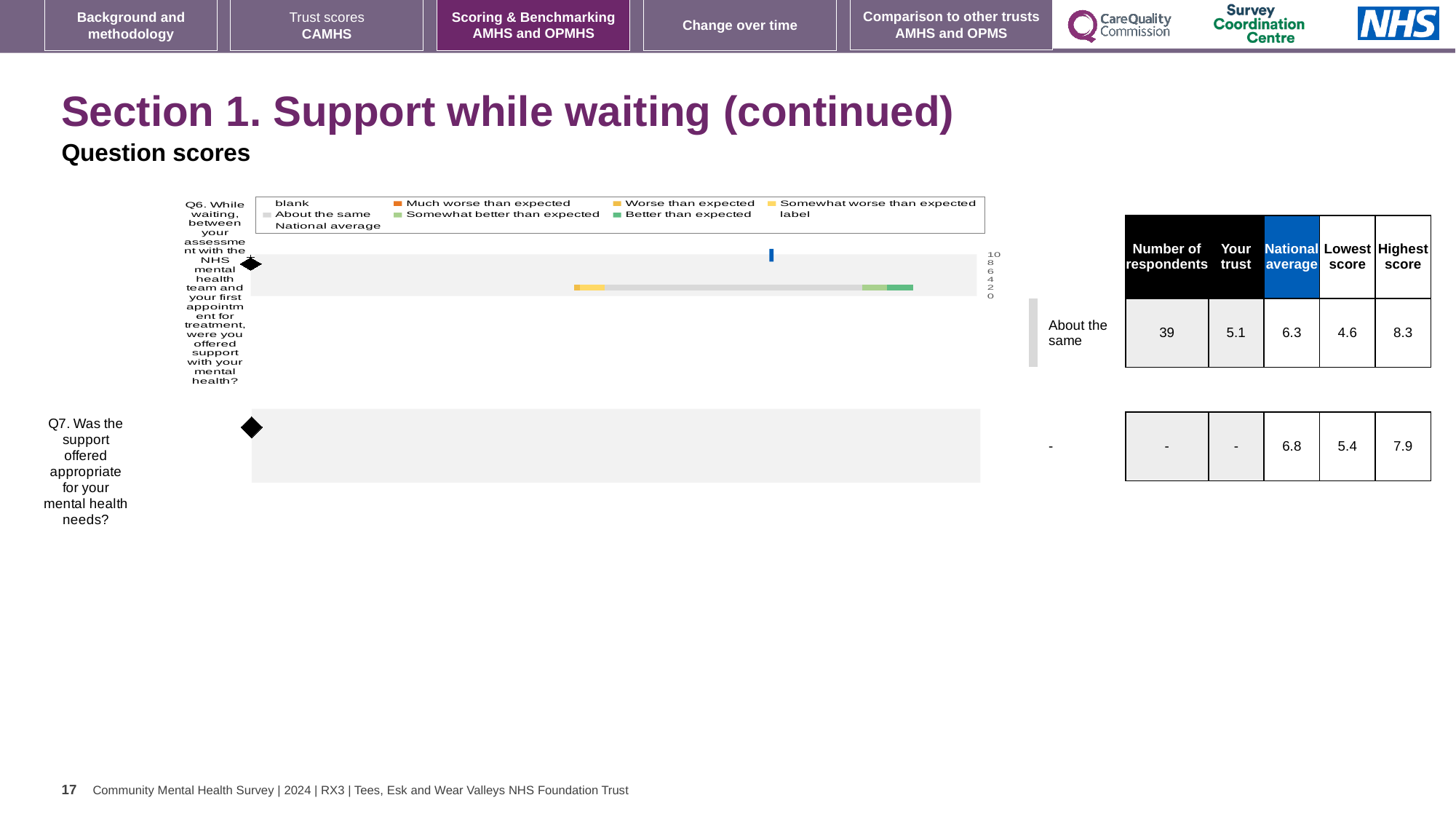
What is the national average score for Q6? 6.3 What is the highest score for Q6? 8.3 What is the maximum value shown on the chart's score axis? 10 What is the 'Your trust' score for Q6 in the table next to the chart? 5.1 How many respondents are listed for Q6? 39 What is the lowest score for Q7? 5.4 What is the difference between the highest and lowest scores for Q6? 3.7 What is the difference between the highest and lowest scores for Q7? 2.5 Which question has the higher national average, Q6 or Q7? Q7 Which is larger for Q6: the 'Your trust' score or the national average? National average What benchmark category is the trust's Q6 score placed in? About the same What kind of chart is shown for Q6 on the slide? bar chart